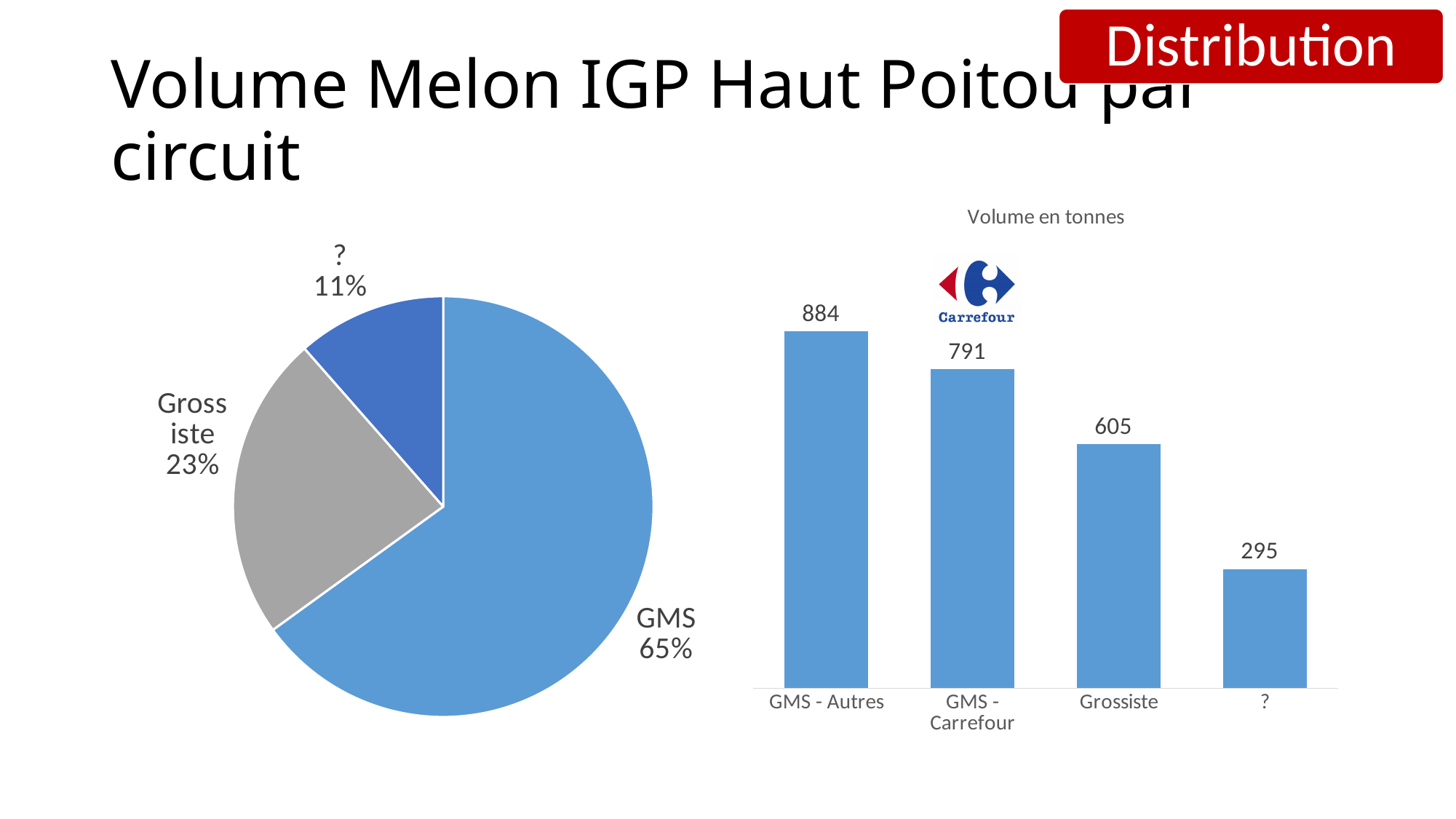
In the bar chart titled 'Volume en tonnes', which category has the highest value? GMS - Autres In the pie chart on the left, what share does Grossiste have? 23% In the bar chart titled 'Volume en tonnes', what is the value for Grossiste? 605 In the bar chart titled 'Volume en tonnes', which is larger, Grossiste or GMS - Carrefour? GMS - Carrefour In the bar chart titled 'Volume en tonnes', which category has the lowest value? ? What kind of chart is the chart on the right of the slide? bar chart In the bar chart titled 'Volume en tonnes', what is the value for GMS - Carrefour? 791 In the pie chart on the left, which slice is the largest? GMS In the bar chart titled 'Volume en tonnes', what is the value for GMS - Autres? 884 In the bar chart titled 'Volume en tonnes', what is the difference between GMS - Autres and GMS - Carrefour? 93 How many bars are in the bar chart titled 'Volume en tonnes'? 4 In the pie chart on the left, what share does GMS have? 65%